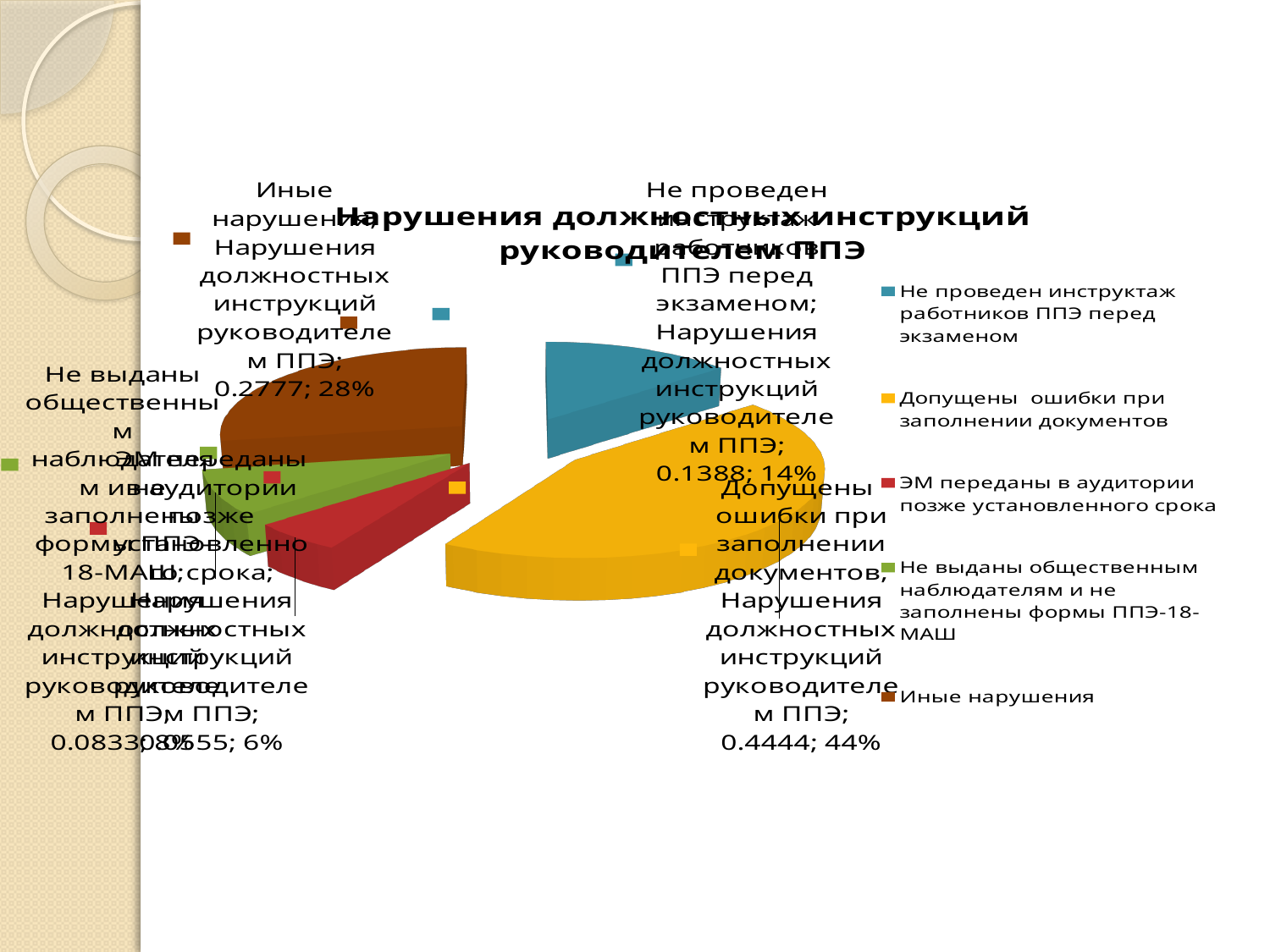
What is the title of the chart? Нарушения должностных инструкций руководителем ППЭ What percentage share is shown for 'ЭМ переданы в аудитории позже установленного срока'? 6% What percentage share is shown for 'Допущены ошибки при заполнении документов'? 44% What type of chart is shown on the slide? pie chart What colour is the slice for 'Допущены ошибки при заполнении документов'? yellow What is the difference in percentage points between 'Допущены ошибки при заполнении документов' and 'Иные нарушения'? 16% Which has a larger share: 'Иные нарушения' or 'Не проведен инструктаж работников ППЭ перед экзаменом'? Иные нарушения What percentage share is shown for 'Иные нарушения'? 28% Which category has the largest share of the pie? Допущены ошибки при заполнении документов What percentage share is shown for 'Не проведен инструктаж работников ППЭ перед экзаменом'? 14% What is the difference in percentage points between 'Иные нарушения' and 'Не проведен инструктаж работников ППЭ перед экзаменом'? 14% How many categories does the legend of the pie chart list? 5